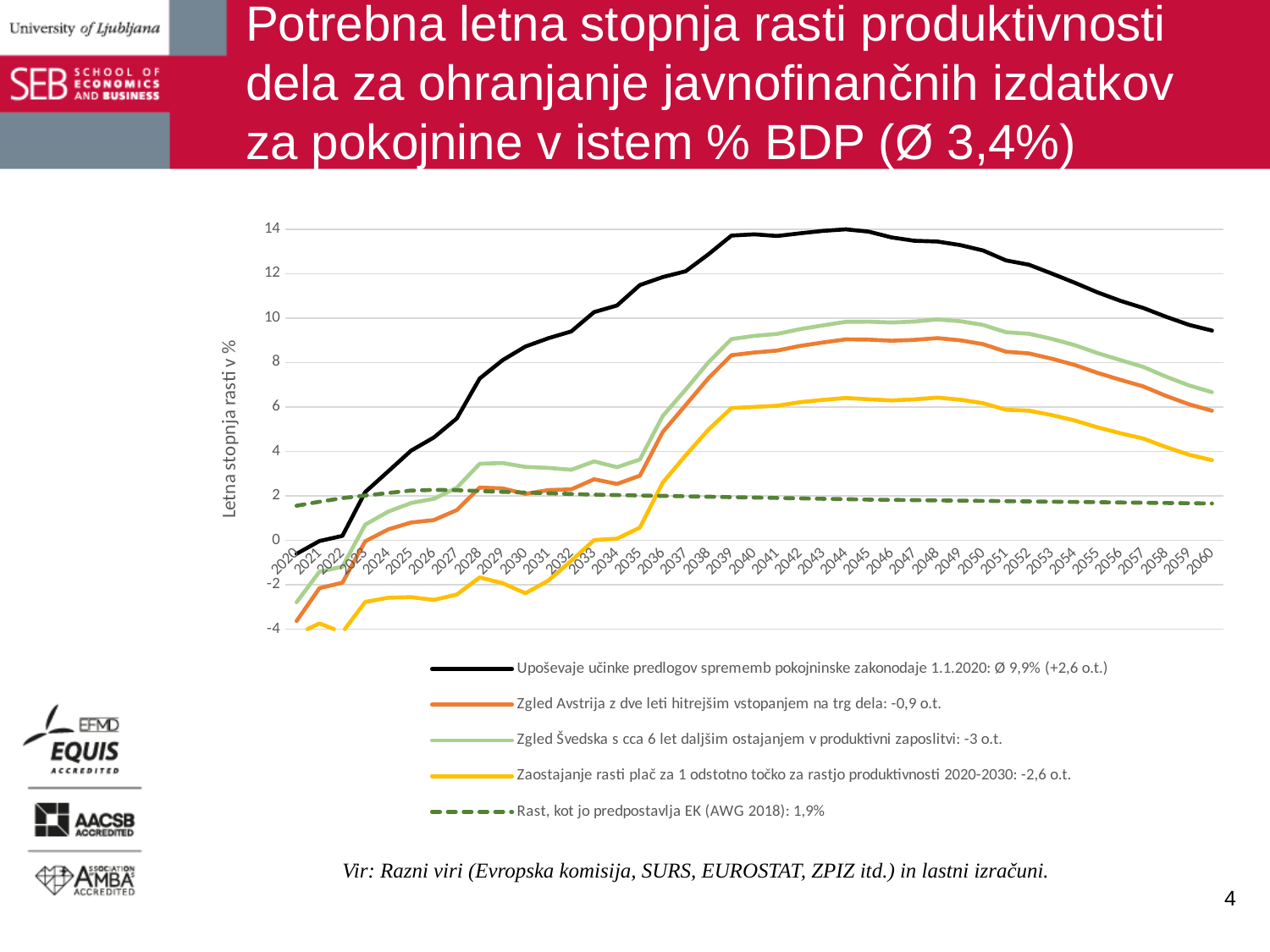
Is the value of the black line (Upoševaje učinke predlogov sprememb pokojninske zakonodaje) in 2040 greater or less than 12? greater In 2050, which is higher: the black line (Upoševaje učinke predlogov) or the yellow line (Zaostajanje rasti plač)? the black line (Upoševaje učinke predlogov) What is the label of the y axis? Letna stopnja rasti v % What kind of chart is shown on the slide? line chart How many years are shown on the x axis of the chart? 41 Is the value of the yellow line (Zaostajanje rasti plač) in 2020 greater or less than -2? less Does the black line (Upoševaje učinke predlogov sprememb pokojninske zakonodaje) rise or fall between 2044 and 2060? fall Which series reaches the highest value on the chart? Upoševaje učinke predlogov sprememb pokojninske zakonodaje 1.1.2020: Ø 9,9% (+2,6 o.t.) Is the value of the dashed line (Rast, kot jo predpostavlja EK) in 2060 greater or less than 4? less Which series has the lowest value in 2020? Zaostajanje rasti plač za 1 odstotno točko za rastjo produktivnosti 2020-2030: -2,6 o.t. How many series does the legend list? 5